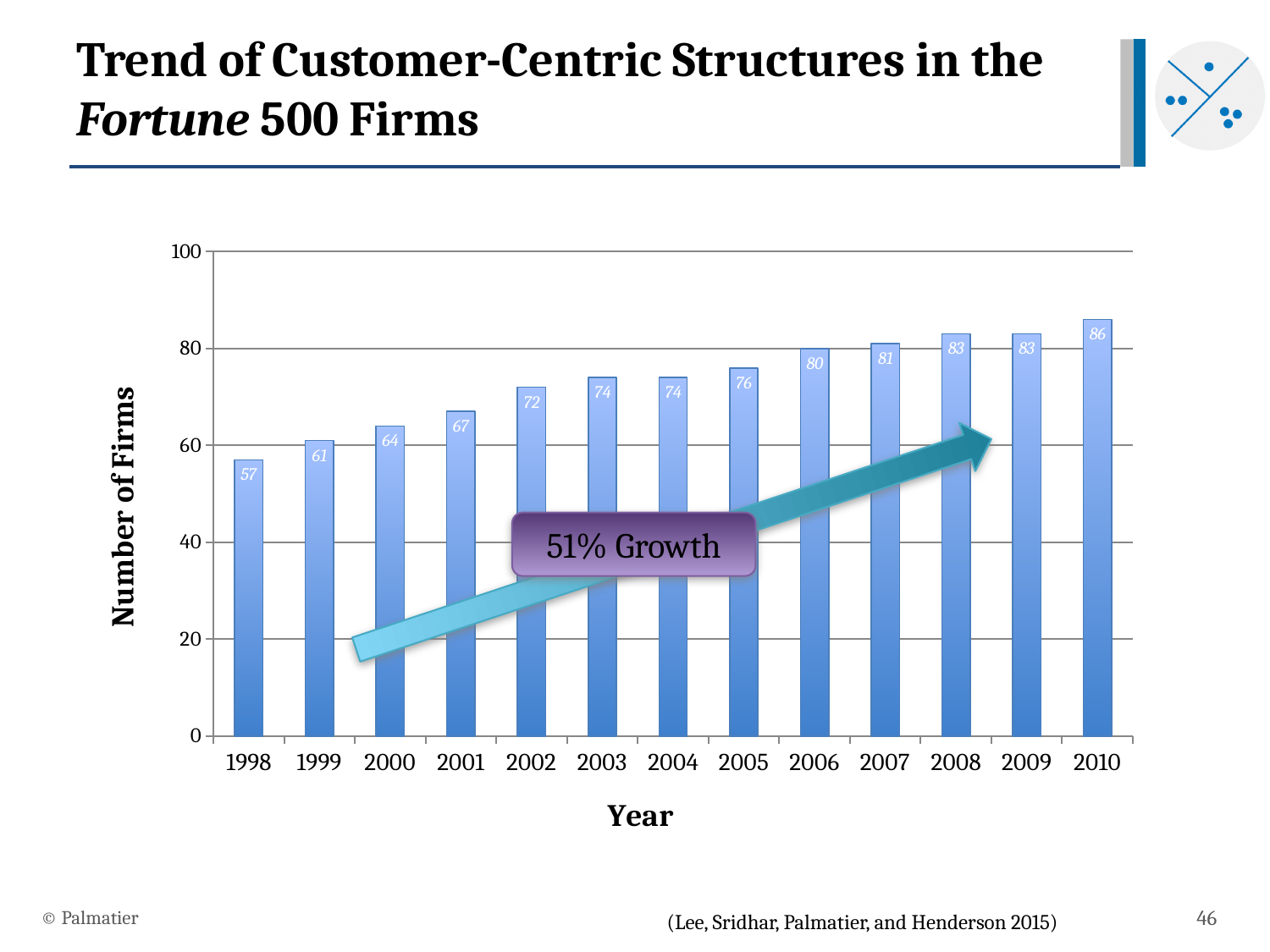
Is the number of firms in 2007 greater or less than 80? greater Which year has the lowest number of firms? 1998 What is the number of firms in 2005? 76 What is the difference in the number of firms between 2006 and 2002? 8 What is the number of firms in 1998? 57 What is the number of firms in 2010? 86 How many years are shown on the x axis? 13 Which year has more firms, 2001 or 2003? 2003 What is the difference in the number of firms between 2010 and 1998? 29 Which year has the highest number of firms? 2010 What growth percentage is called out in the label on the chart? 51% Growth What type of chart is shown on the slide? bar chart